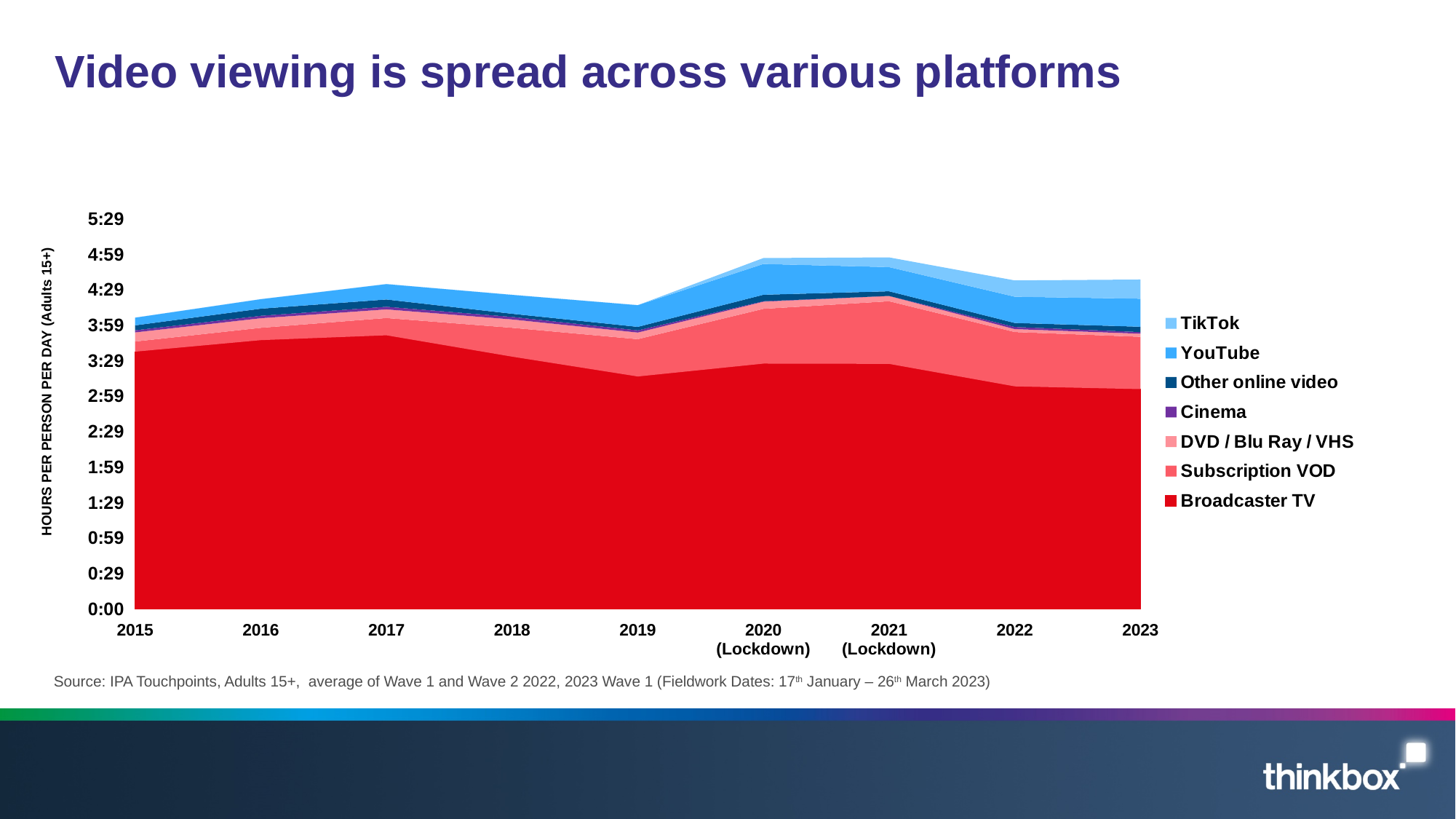
Is the value for Broadcaster TV in 2023 greater or less than 3:29? less Which series is plotted at the bottom of the stack? Broadcaster TV What is the y-axis label of the chart? HOURS PER PERSON PER DAY (Adults 15+) Does the total stacked value rise or fall from 2019 to 2020 (Lockdown)? rise Which year has the larger Broadcaster TV value, 2017 or 2023? 2017 Is the total stacked value in 2015 greater or less than 4:29? less Does the Broadcaster TV value rise or fall from 2021 (Lockdown) to 2023? fall Is the value for Broadcaster TV in 2017 greater or less than 3:29? greater How many series does the legend list? 7 How many years are shown along the x axis? 9 What kind of chart is shown on the slide? Stacked area chart